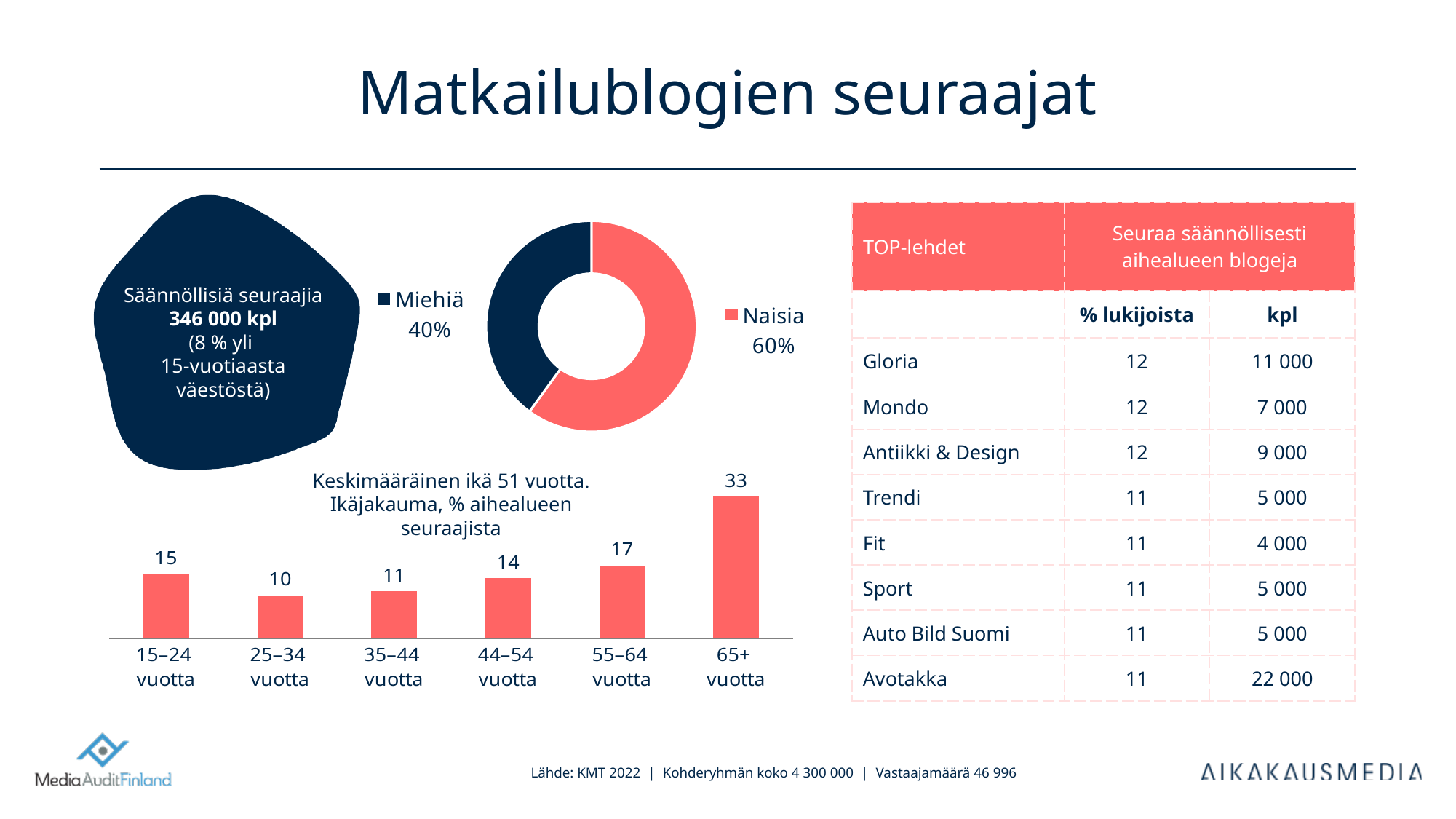
How many entries does the legend of the donut chart list? 2 In the age distribution bar chart, what is the value for 25–34 vuotta? 10 In the age distribution bar chart, what is the value for 65+ vuotta? 33 In the donut chart, which group is larger, Miehiä or Naisia? Naisia In the donut chart, what share of followers are Miehiä? 40% How many age groups are shown in the age distribution bar chart? 6 In the age distribution bar chart, which age group has the highest value? 65+ vuotta What kind of chart shows the Miehiä and Naisia shares? Donut chart In the age distribution bar chart, which is larger, the value for 15–24 vuotta or 44–54 vuotta? 15–24 vuotta In the age distribution bar chart, which age group has the lowest value? 25–34 vuotta In the donut chart, what share of followers are Naisia? 60% In the age distribution bar chart, what is the difference between the values for 65+ vuotta and 55–64 vuotta? 16